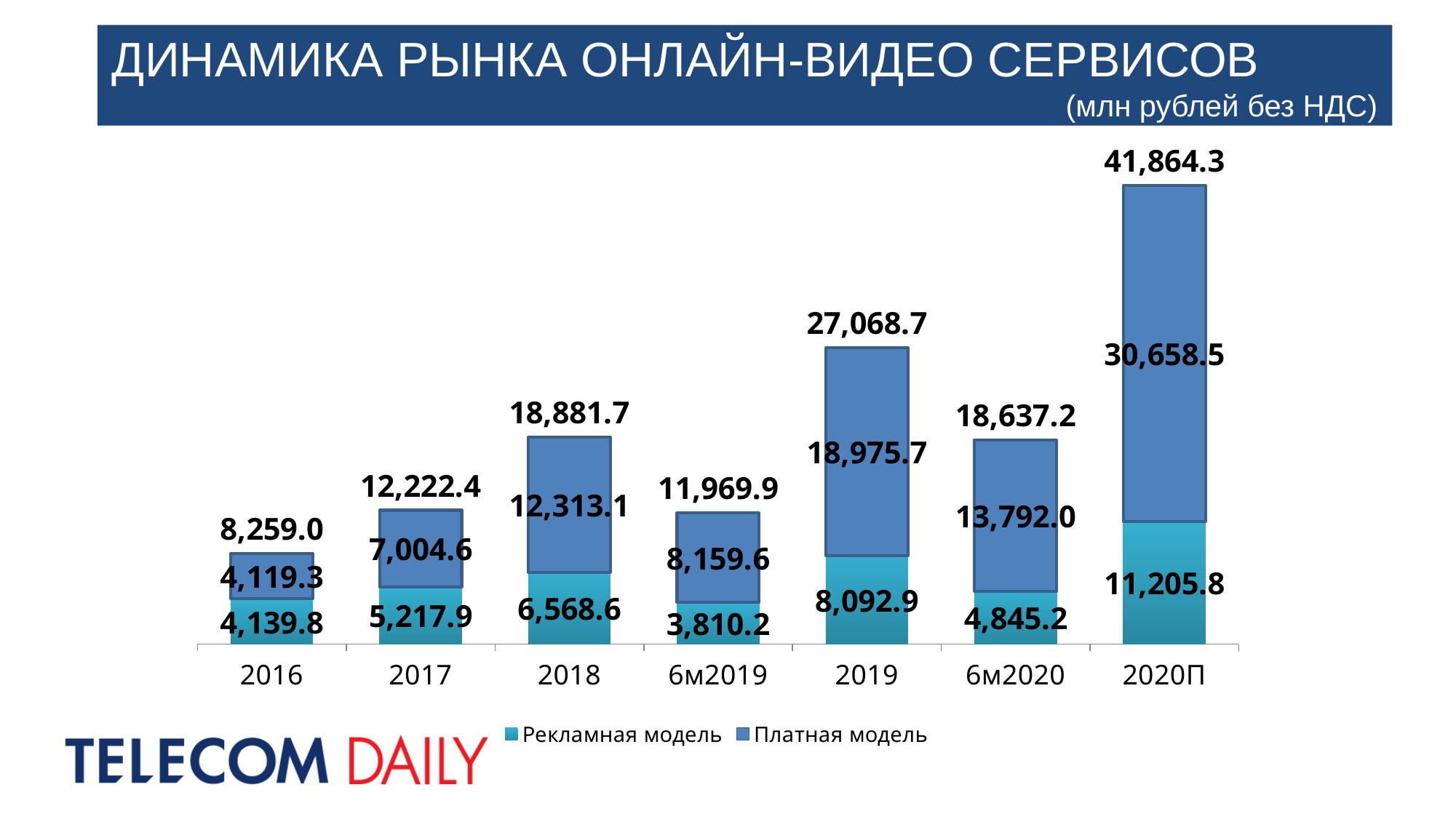
Which category has the lowest total value? 2016 How many categories are shown on the x axis? 7 Which category has the highest total value? 2020П What is the value of the Платная модель series for 2019? 18,975.7 What is the difference between the Платная модель values for 2020П and 2019? 11,682.8 What is the total value of the stacked bar for 6м2019? 11,969.9 What is the value of the Рекламная модель series for 2018? 6,568.6 Which is larger: the Рекламная модель value for 6м2020 or for 6м2019? 6м2020 What unit is stated in the chart title? млн рублей без НДС How many series does the legend list? 2 What is the total value of the stacked bar for 2020П? 41,864.3 What kind of chart is shown on the slide? Stacked bar chart